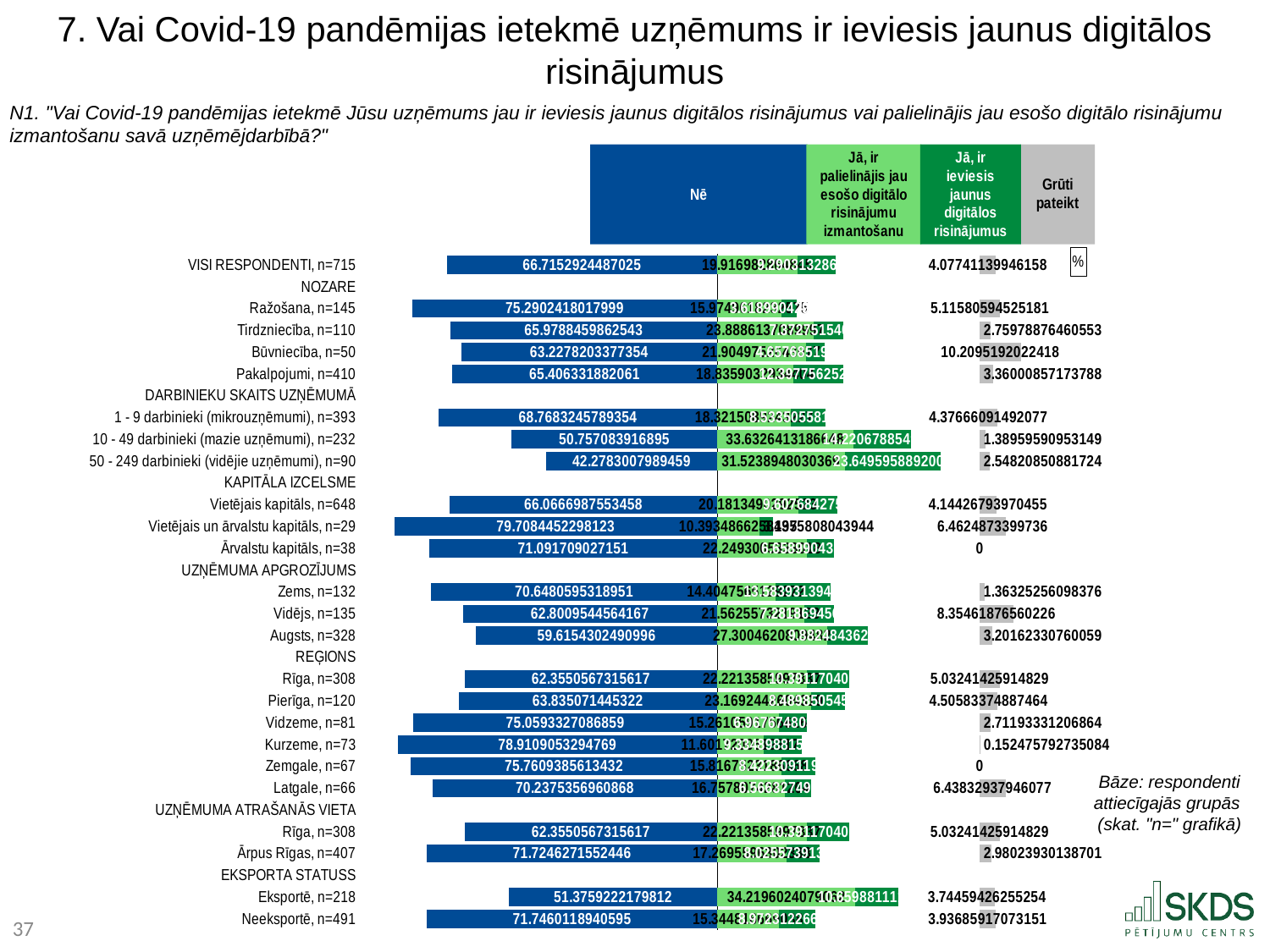
What is the "Nē" value for VISI RESPONDENTI, n=715? 66.7152924487025 Which colour represents the "Nē" series in the chart? Blue Which group has the highest "Grūti pateikt" value? Būvniecība, n=50 What is the "Grūti pateikt" value for Būvniecība, n=50? 10.2095192022418 How many series does the legend list? 4 Which group has the lowest "Nē" value? 50 - 249 darbinieki (vidējie uzņēmumi), n=90 What is the "Nē" value for 50 - 249 darbinieki (vidējie uzņēmumi), n=90? 42.2783007989459 What is the "Grūti pateikt" value for Ārvalstu kapitāls, n=38? 0 Which group has the highest "Nē" value? Vietējais un ārvalstu kapitāls, n=29 Which has a larger "Nē" value: Eksportē, n=218 or Neeksportē, n=491? Neeksportē, n=491 What kind of chart is shown on the slide? Stacked bar chart What is the "Grūti pateikt" value for Kurzeme, n=73? 0.152475792735084